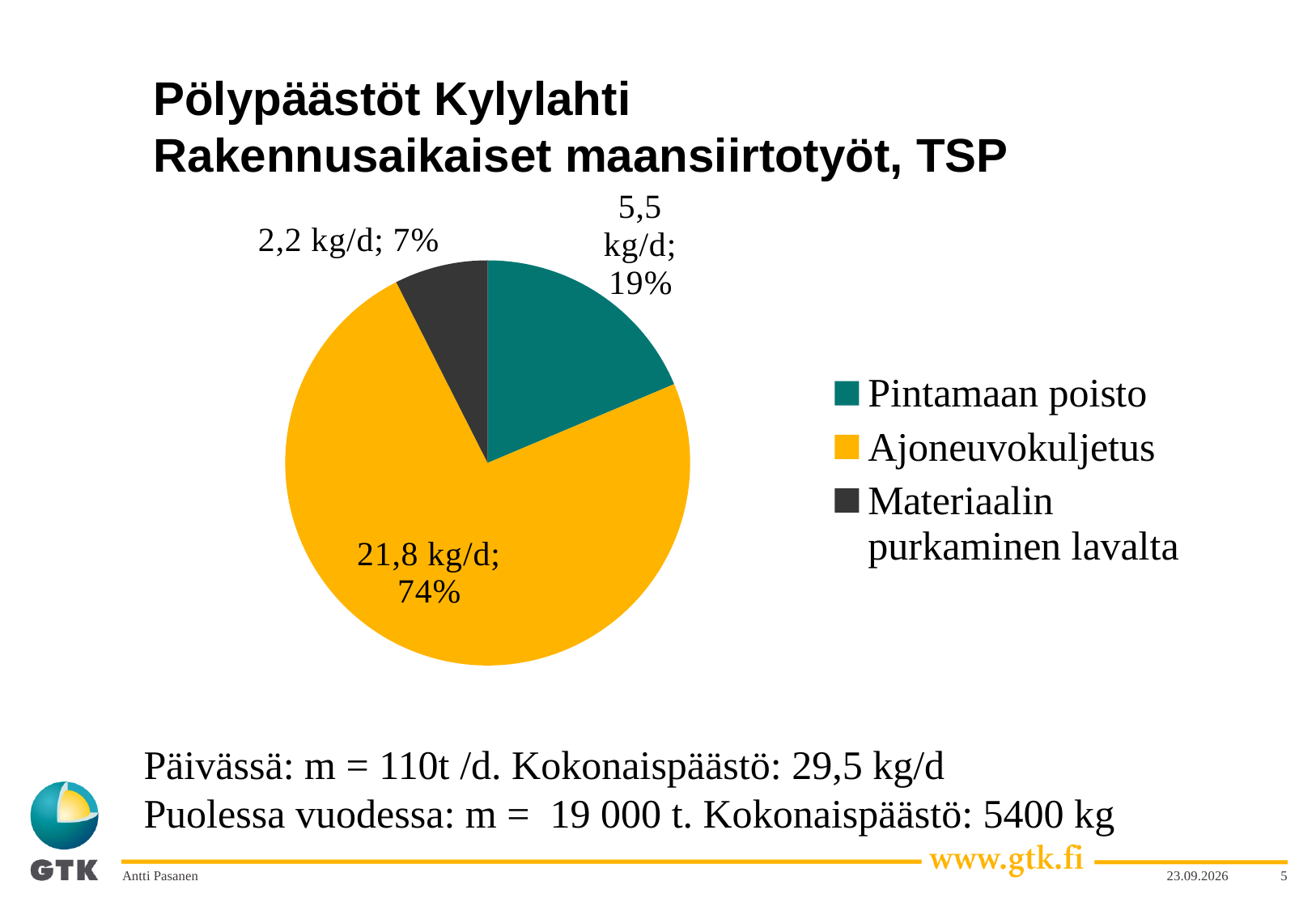
What is the value for Materiaalin purkaminen lavalta? 2,2 kg/d What is the value for Ajoneuvokuljetus? 21,8 kg/d Which category has the largest slice of the pie? Ajoneuvokuljetus Which colour represents Pintamaan poisto in the pie chart? teal What is the difference in kg/d between Ajoneuvokuljetus and Pintamaan poisto? 16,3 kg/d What share of the pie does Ajoneuvokuljetus represent? 74% What share of the pie does Pintamaan poisto represent? 19% What is the value for Pintamaan poisto? 5,5 kg/d What kind of chart is shown on the slide? pie chart How many slices does the pie chart have? 3 Which category has the smallest slice of the pie? Materiaalin purkaminen lavalta What share of the pie does Materiaalin purkaminen lavalta represent? 7%